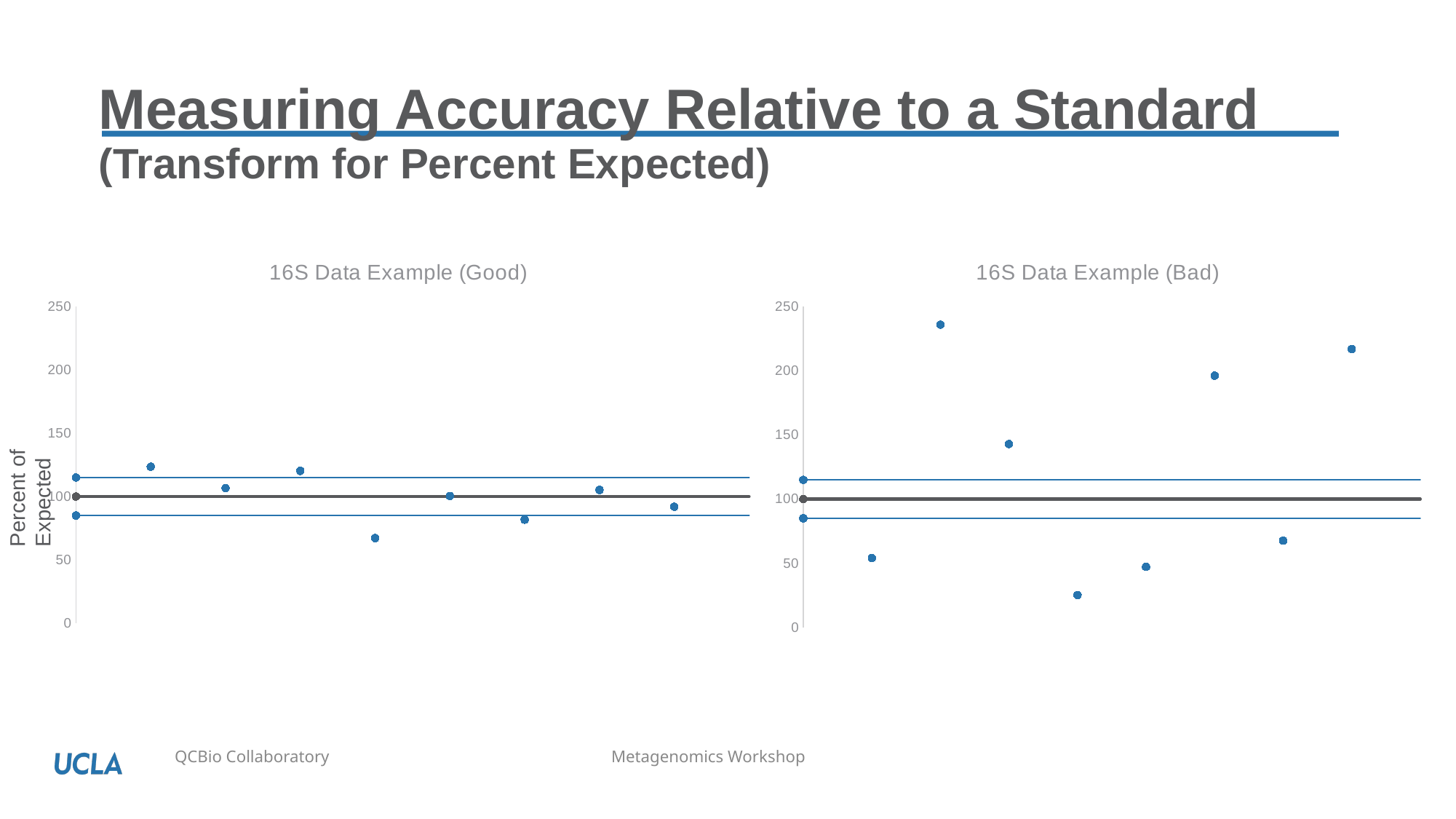
In the "16S Data Example (Bad)" chart, is the highest plotted point greater or less than 200? greater In the "16S Data Example (Good)" chart, is the lowest plotted point greater or less than 50? greater Which chart has its points spread further from the 100 reference line, "16S Data Example (Good)" or "16S Data Example (Bad)"? 16S Data Example (Bad) What kind of chart is the "16S Data Example (Good)" chart? scatter chart What is the highest value shown on the y axis of the "16S Data Example (Bad)" chart? 250 In the "16S Data Example (Good)" chart, is the highest plotted point greater or less than 150? less How many data points are plotted in the "16S Data Example (Bad)" chart? 8 What is the y-axis label shown to the left of the "16S Data Example (Good)" chart? Percent of Expected How many data points are plotted in the "16S Data Example (Good)" chart? 8 What kind of chart is the "16S Data Example (Bad)" chart? scatter chart